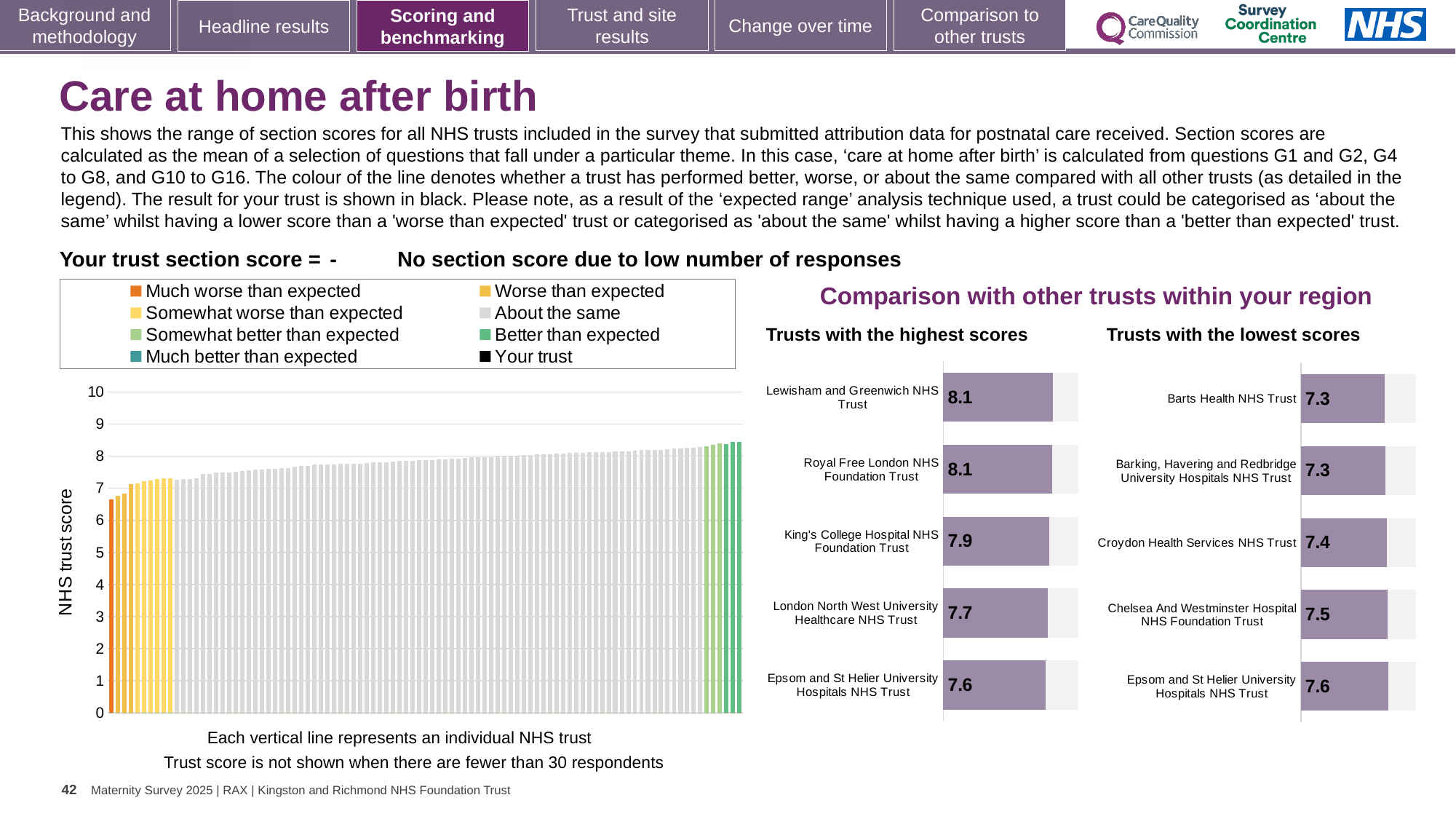
How many trusts are listed in the 'Trusts with the highest scores' chart? 5 In the 'Trusts with the highest scores' chart, what is the difference between the scores of Lewisham and Greenwich NHS Trust and Epsom and St Helier University Hospitals NHS Trust? 0.5 In the 'Trusts with the lowest scores' chart, which has the higher score: Croydon Health Services NHS Trust or Chelsea And Westminster Hospital NHS Foundation Trust? Chelsea And Westminster Hospital NHS Foundation Trust In the 'Trusts with the lowest scores' chart, which trust has the highest score? Epsom and St Helier University Hospitals NHS Trust In the 'Trusts with the highest scores' chart, which trust has the lowest score? Epsom and St Helier University Hospitals NHS Trust How many entries does the legend above the large 'NHS trust score' chart list? 8 In the large 'NHS trust score' chart on the left, do the bar values rise or fall from left to right? Rise In the 'Trusts with the highest scores' chart, what is the score for King's College Hospital NHS Foundation Trust? 7.9 In the 'Trusts with the lowest scores' chart, what is the score for Croydon Health Services NHS Trust? 7.4 In the 'Trusts with the highest scores' chart, which has the higher score: King's College Hospital NHS Foundation Trust or London North West University Healthcare NHS Trust? King's College Hospital NHS Foundation Trust In the 'Trusts with the lowest scores' chart, what is the difference between the scores of Epsom and St Helier University Hospitals NHS Trust and Barts Health NHS Trust? 0.3 What kind of chart is the large 'NHS trust score' chart on the left of the slide? Bar chart